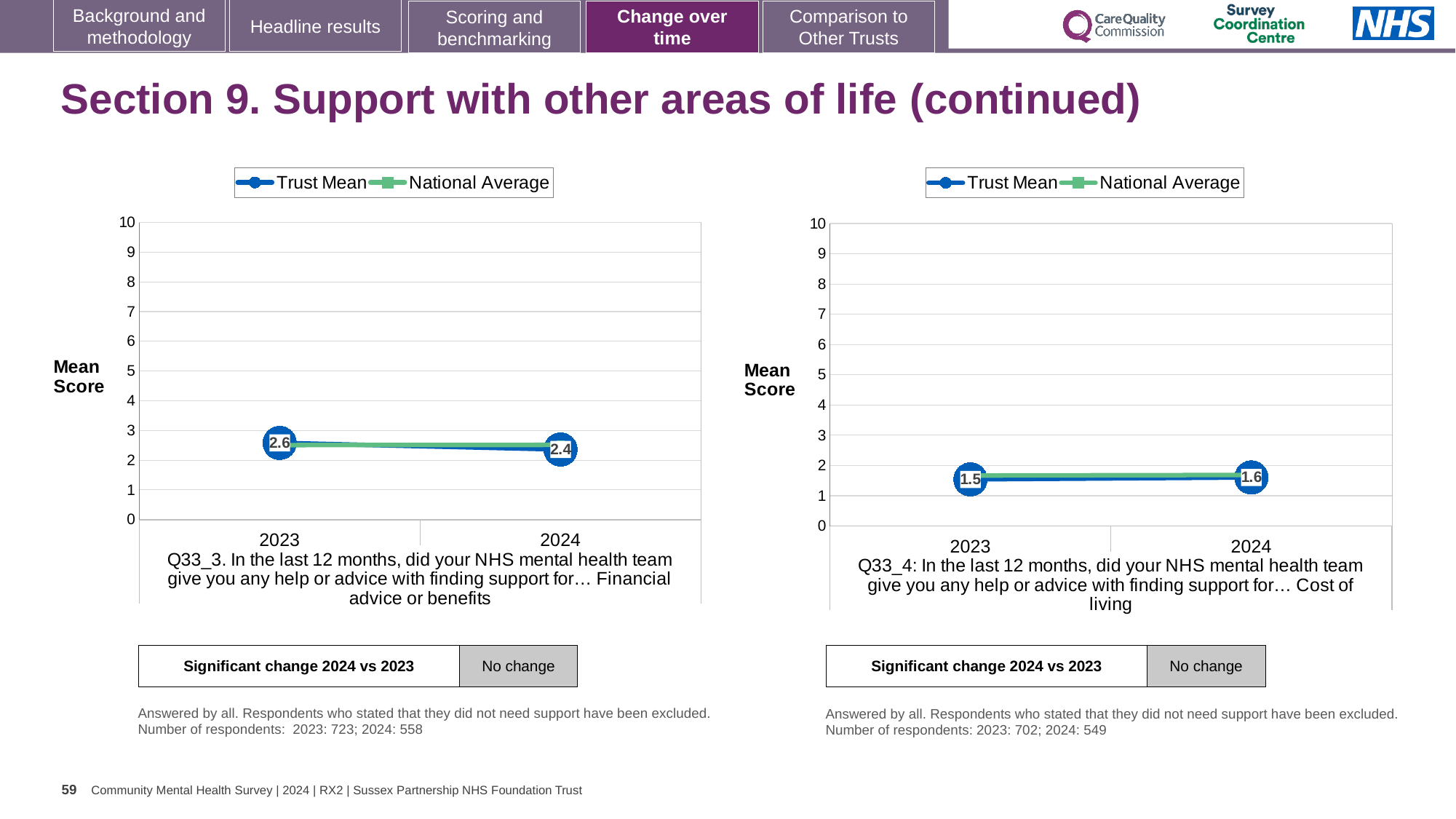
On the left chart (Q33_3, Financial advice or benefits), does the Trust Mean rise or fall from 2023 to 2024? fall On the right chart (Q33_4, Cost of living), what is the difference between the Trust Mean for 2024 and 2023? 0.1 On the right chart (Q33_4, Cost of living), does the Trust Mean rise or fall from 2023 to 2024? rise On the left chart (Q33_3, Financial advice or benefits), by how much did the Trust Mean change from 2023 to 2024? 0.2 How many series does the legend of the right chart (Q33_4, Cost of living) list? 2 On the left chart (Q33_3, Financial advice or benefits), what is the Trust Mean score for 2023? 2.6 What type of chart is the left chart (Q33_3, Financial advice or benefits)? line chart On the left chart (Q33_3, Financial advice or benefits), is the Trust Mean for 2023 greater or less than 3? less On the left chart (Q33_3, Financial advice or benefits), what is the Trust Mean score for 2024? 2.4 On the right chart (Q33_4, Cost of living), what is the Trust Mean score for 2024? 1.6 On the right chart (Q33_4, Cost of living), what is the Trust Mean score for 2023? 1.5 How many years are plotted on the x axis of the right chart (Q33_4, Cost of living)? 2